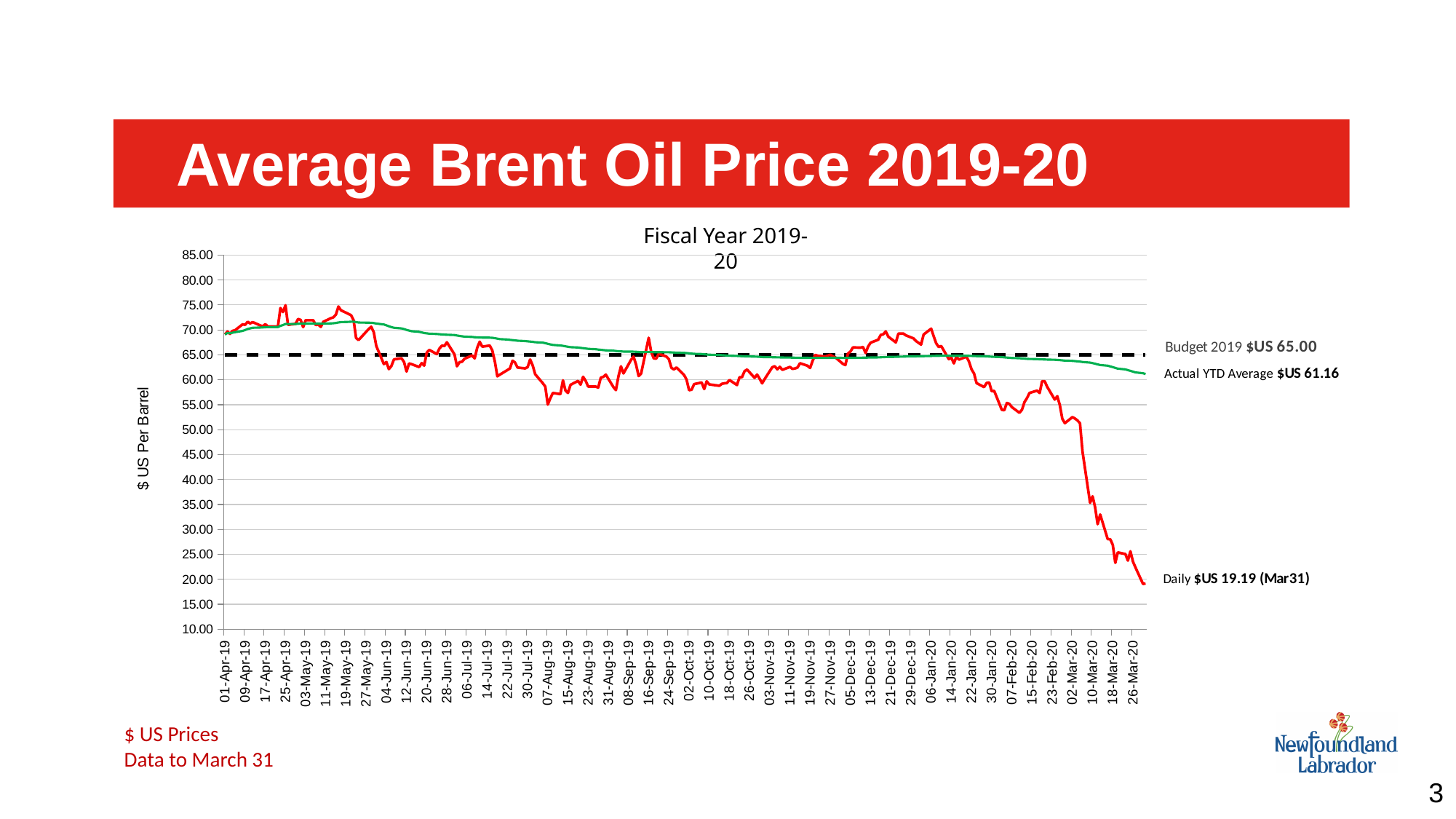
How many lines are plotted on the chart? 3 What is the Daily Brent oil price on Mar 31 shown on the chart? $US 19.19 By how much is the Budget 2019 price higher than the Actual YTD Average? $US 3.84 Is the daily price on 01-Apr-19 greater or less than 65.00? greater Does the daily price rise or fall between 06-Jan-20 and 26-Mar-20? fall What is the Budget 2019 oil price shown on the chart? $US 65.00 What is the difference between the Budget 2019 price and the Daily price on Mar 31? $US 45.81 Is the daily price on 10-Mar-20 greater or less than 50.00? less What kind of chart is shown on the slide? line chart What is the Actual YTD Average Brent oil price shown on the chart? $US 61.16 What is the label on the vertical axis of the chart? $ US Per Barrel Which is larger, the Actual YTD Average or the Budget 2019 price? Budget 2019